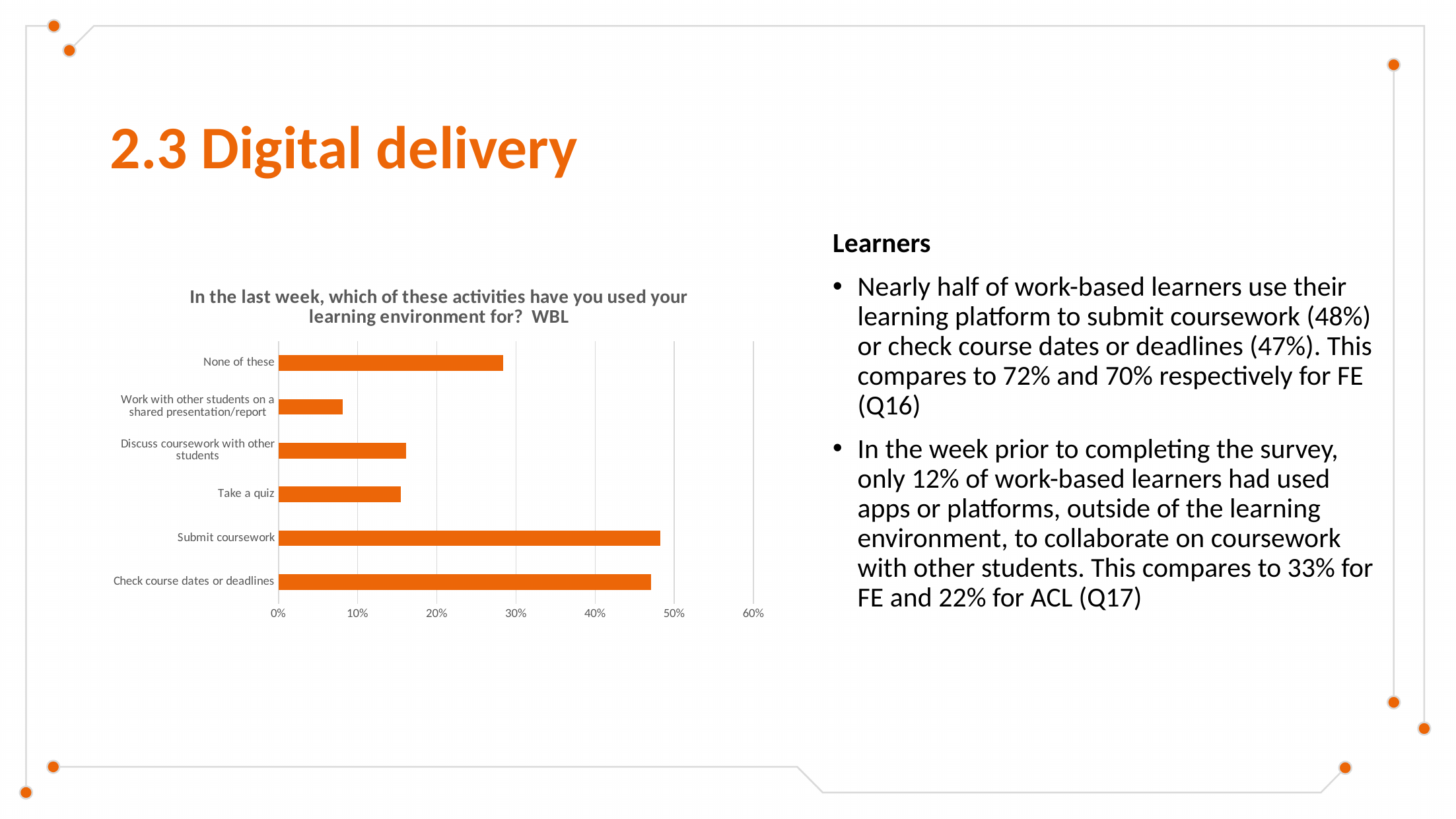
Is the value for "Submit coursework" greater or less than 40%? greater Is the value for "Take a quiz" greater or less than 20%? less Is the value for "Check course dates or deadlines" greater or less than 50%? less What is the title of the chart? In the last week, which of these activities have you used your learning environment for? WBL How many activity categories are plotted in the chart? 6 What kind of chart is shown on the slide? Bar chart Which activity has the lowest value in the chart? Work with other students on a shared presentation/report Which is larger: the value for "None of these" or the value for "Discuss coursework with other students"? None of these Which is larger: the value for "Take a quiz" or the value for "Work with other students on a shared presentation/report"? Take a quiz